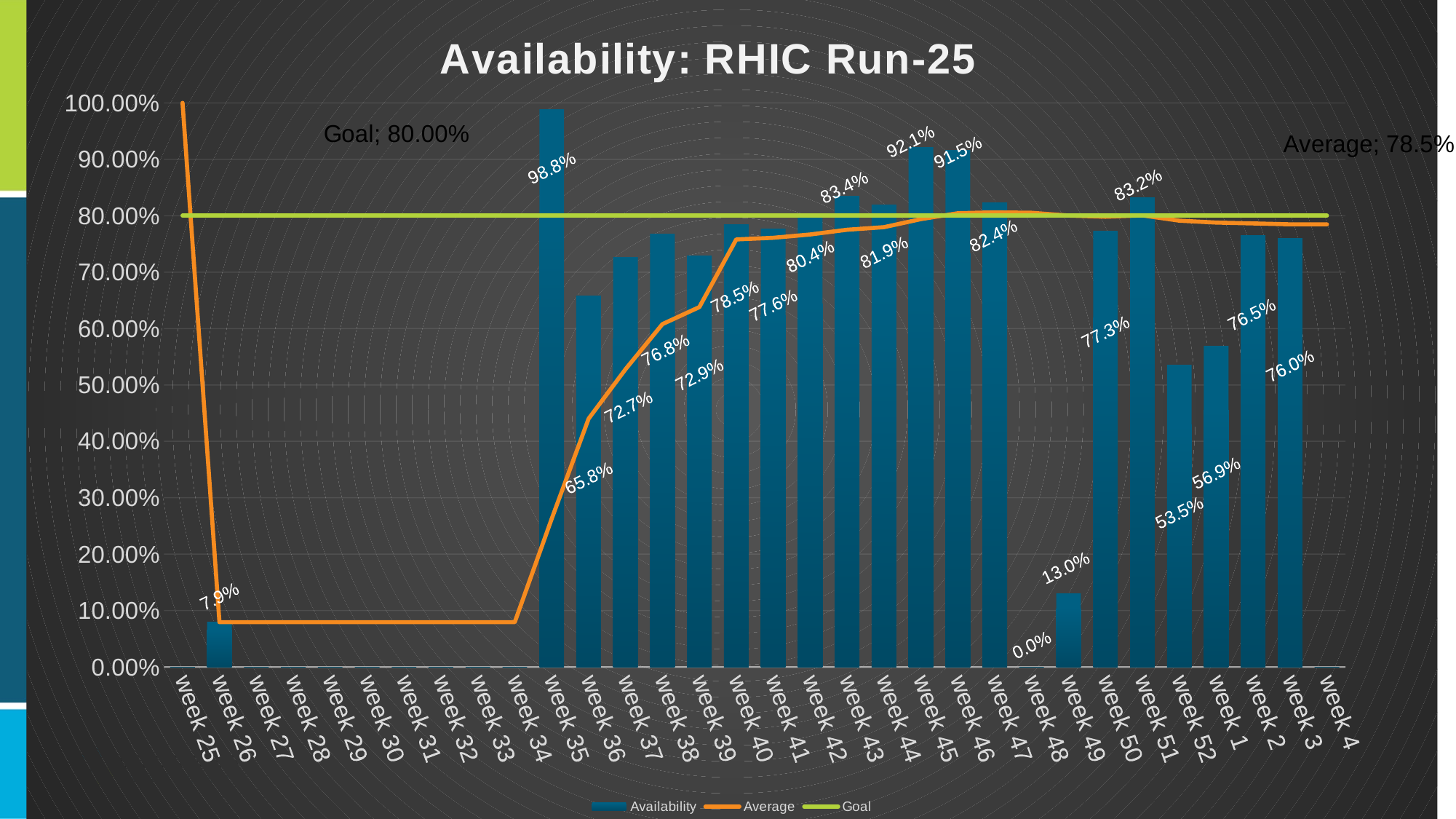
What is the difference between the Availability values for week 45 and week 46? 0.6% Which week has the highest Availability value? week 35 What Goal value is labelled on the chart? 80.00% How many series does the legend list? 3 What is the difference between the Availability values for week 35 and week 36? 33.0% Is the Availability value for week 36 greater or less than 60%? greater Which has the larger Availability value, week 52 or week 1? week 1 What is the Availability value for week 26? 7.9% How many week categories are shown on the x axis? 32 What is the Availability value for week 45? 92.1% What kind of chart is shown on the slide? combination bar and line chart What is the Availability value for week 49? 13.0%